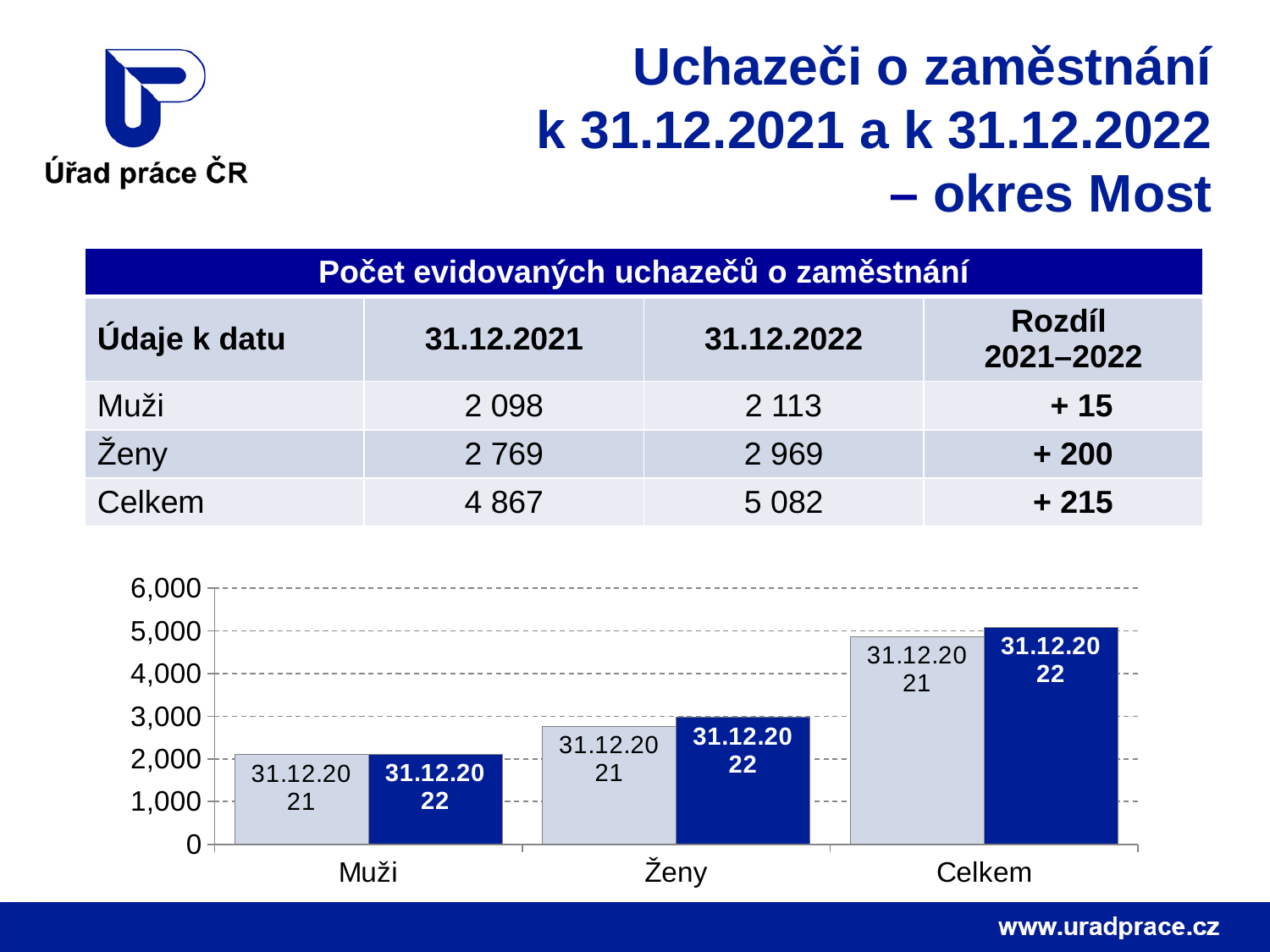
What is the value for Ženy on 31.12.2022, as given in the table above the chart? 2 969 For Ženy, which bar is taller: 31.12.2021 or 31.12.2022? 31.12.2022 Which category has the highest bars in the chart? Celkem Is the value for Celkem on 31.12.2022 greater or less than 5,000? greater Is the value for Muži on 31.12.2021 greater or less than 3,000? less Is the value for Ženy on 31.12.2022 greater or less than 2,000? greater How many series does the chart show for each category? 2 What kind of chart is shown on the slide? bar chart What is the highest value shown on the chart's y axis? 6,000 What is the difference between the Celkem values for 31.12.2022 and 31.12.2021, as given in the table? + 215 How many categories are shown on the x axis of the chart? 3 Which category has the lowest bars in the chart? Muži